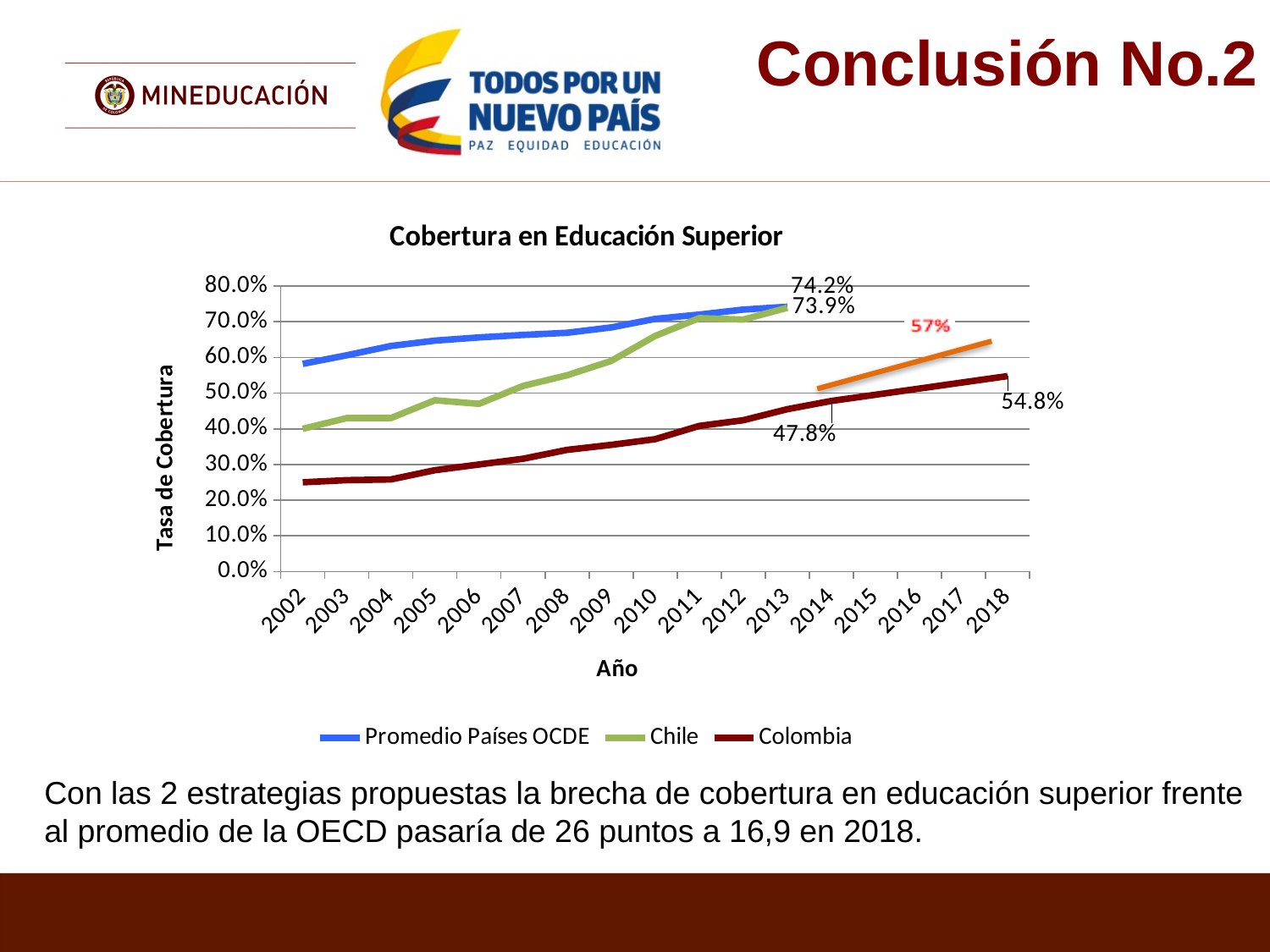
Which series has the lowest value in 2013? Colombia Does the Colombia line rise or fall from 2002 to 2018? Rises What is the title of the chart? Cobertura en Educación Superior What kind of chart is shown on the slide? Line chart What is the value for Promedio Países OCDE in 2013? 74.2% What is the value for Chile in 2013? 73.9% What is the value for Colombia in 2018? 54.8% How many series does the legend of the chart list? 3 Is the value for Colombia in 2002 greater or less than 30.0%? less